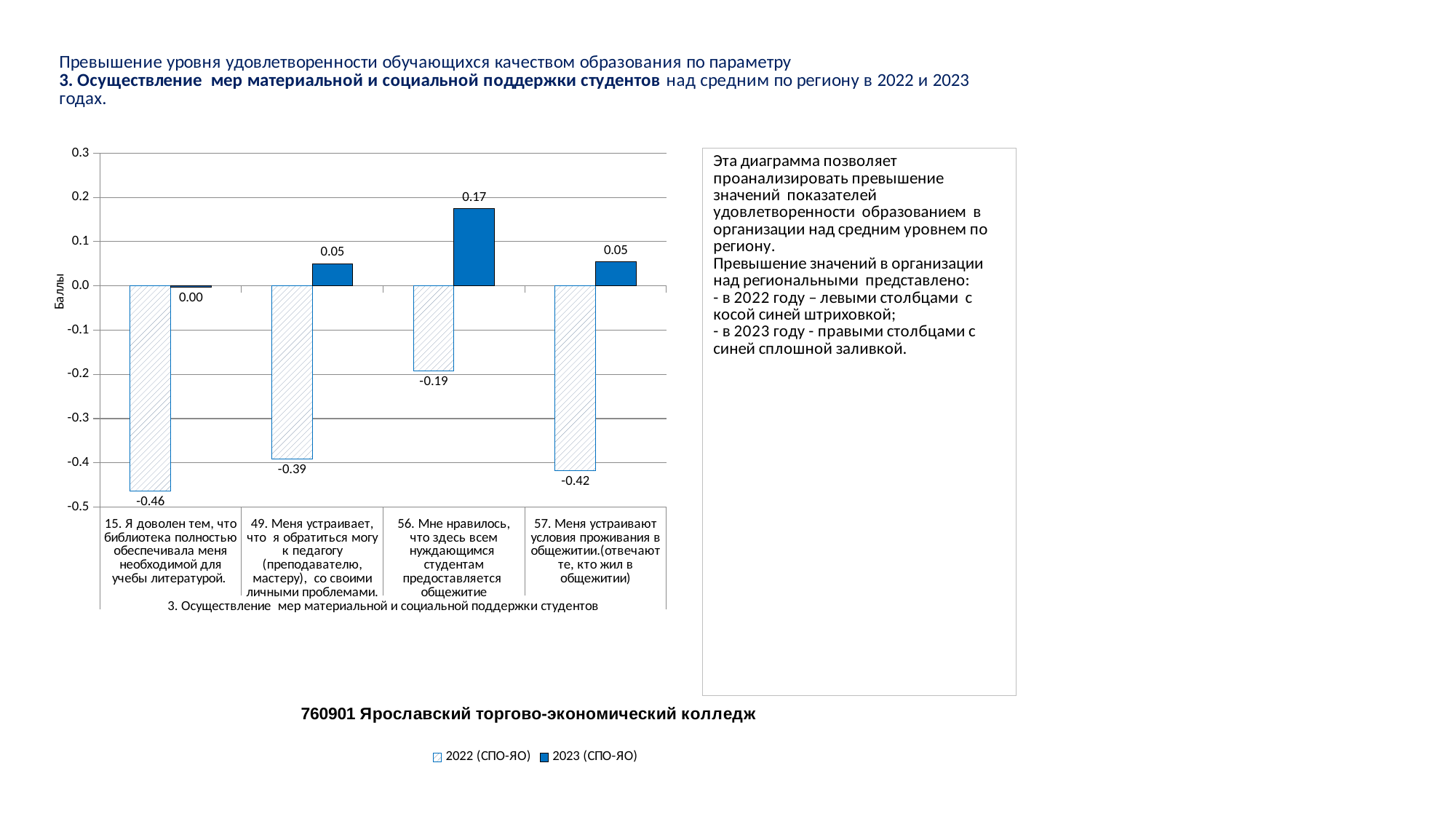
What is the label of the y axis of the chart? Баллы Which category has the highest 2023 (СПО-ЯО) value? 56. Мне нравилось, что здесь всем нуждающимся студентам предоставляется общежитие What is the 2022 (СПО-ЯО) value for category 15 (Я доволен тем, что библиотека полностью обеспечивала меня необходимой для учебы литературой)? -0.46 What is the difference between the 2023 and 2022 values for category 56? 0.36 What type of chart is shown on the slide? Bar chart Which is larger for category 49: the 2022 (СПО-ЯО) value or the 2023 (СПО-ЯО) value? 2023 (СПО-ЯО) What is the 2023 (СПО-ЯО) value for category 49 (Меня устраивает, что я обратиться могу к педагогу)? 0.05 How many series does the chart legend list? 2 What is the 2023 (СПО-ЯО) value for category 56 (Мне нравилось, что здесь всем нуждающимся студентам предоставляется общежитие)? 0.17 How many categories are shown on the x axis of the chart? 4 Which category has the lowest 2022 (СПО-ЯО) value? 15. Я доволен тем, что библиотека полностью обеспечивала меня необходимой для учебы литературой What is the 2022 (СПО-ЯО) value for category 57 (Меня устраивают условия проживания в общежитии)? -0.42